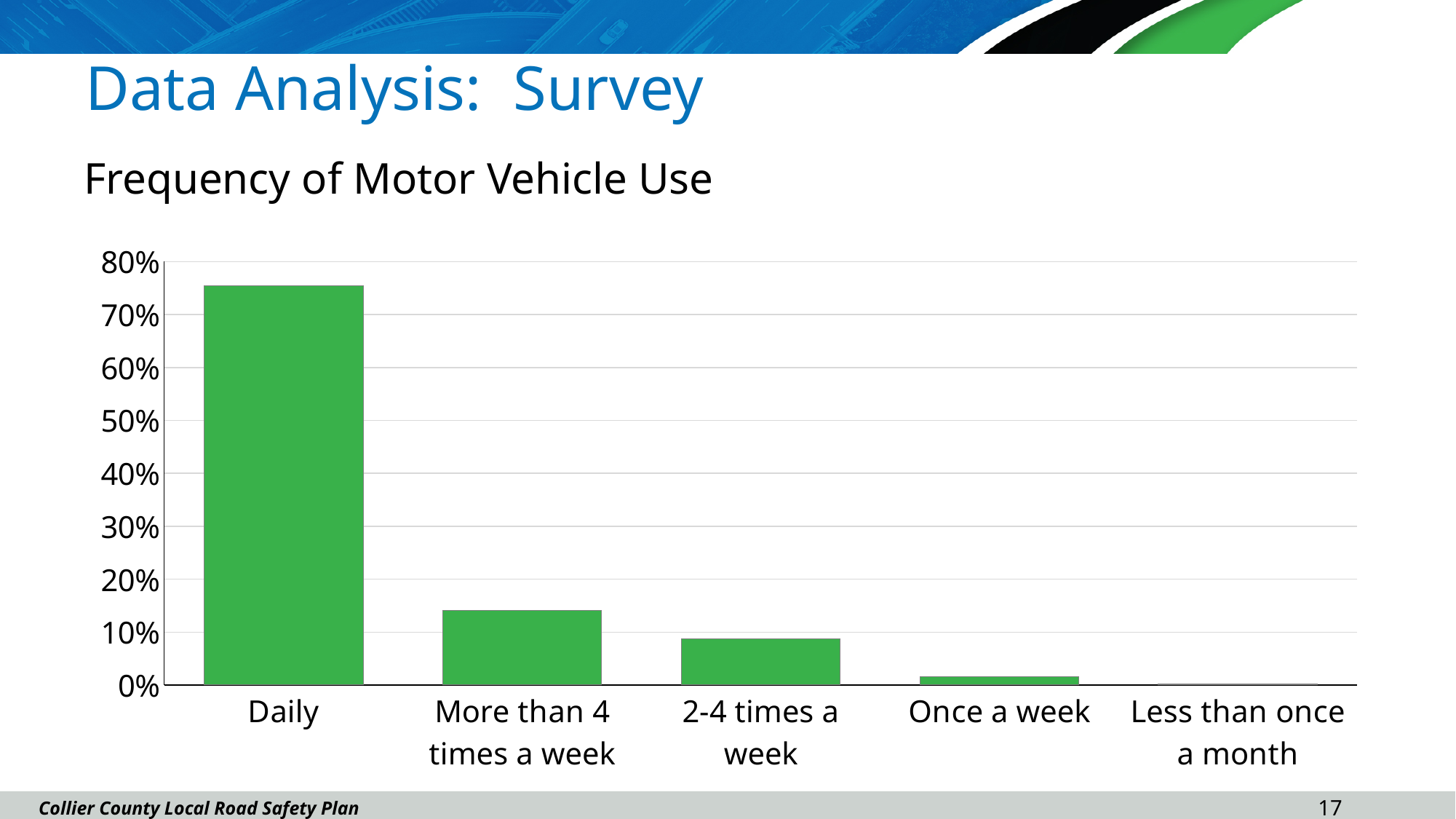
Which category has the lowest value in the chart? Less than once a month What kind of chart is shown on the slide? bar chart Is the value for Daily greater or less than 70%? greater Which is larger, the value for More than 4 times a week or the value for 2-4 times a week? More than 4 times a week What is the title of the chart? Frequency of Motor Vehicle Use Is the value for More than 4 times a week greater or less than 20%? less Is the value for 2-4 times a week greater or less than 10%? less Do the values rise or fall moving from left to right along the x axis? fall What colour are the bars in the chart? green Which category has the highest value in the chart? Daily How many categories are shown on the x axis of the chart? 5